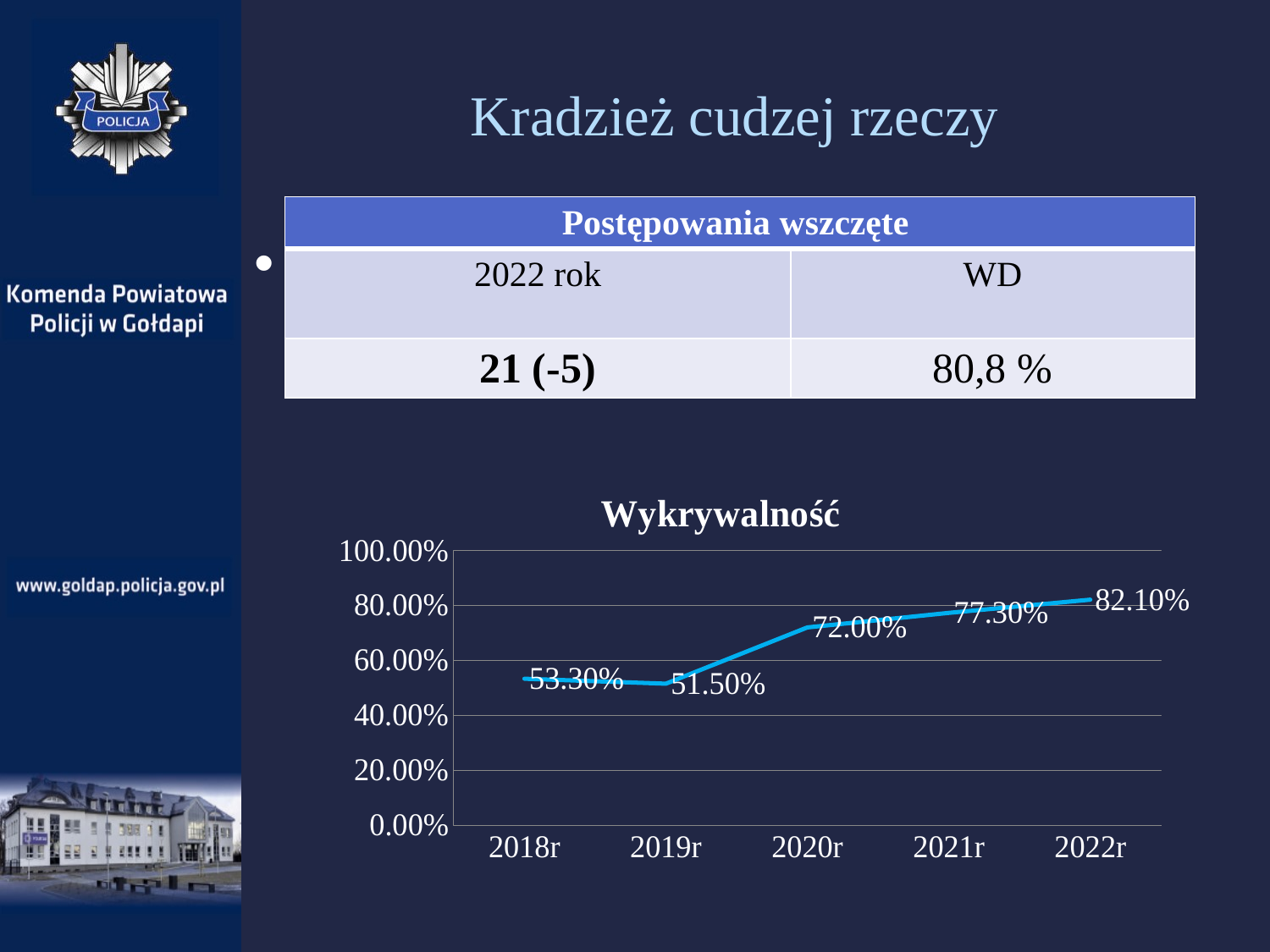
Which year has the highest value in the Wykrywalność chart? 2022r What is the value for 2021r in the Wykrywalność chart? 77.30% How many years are plotted in the Wykrywalność chart? 5 What is the value for 2020r in the Wykrywalność chart? 72.00% What is the value for 2019r in the Wykrywalność chart? 51.50% Which is larger in the Wykrywalność chart, the value for 2020r or 2021r? 2021r What is the value for 2018r in the Wykrywalność chart? 53.30% Which year has the lowest value in the Wykrywalność chart? 2019r What kind of chart is the Wykrywalność chart? line chart What is the value for 2022r in the Wykrywalność chart? 82.10% What is the title of the chart on the slide? Wykrywalność What is the difference between the 2022r and 2018r values in the Wykrywalność chart? 28.80%